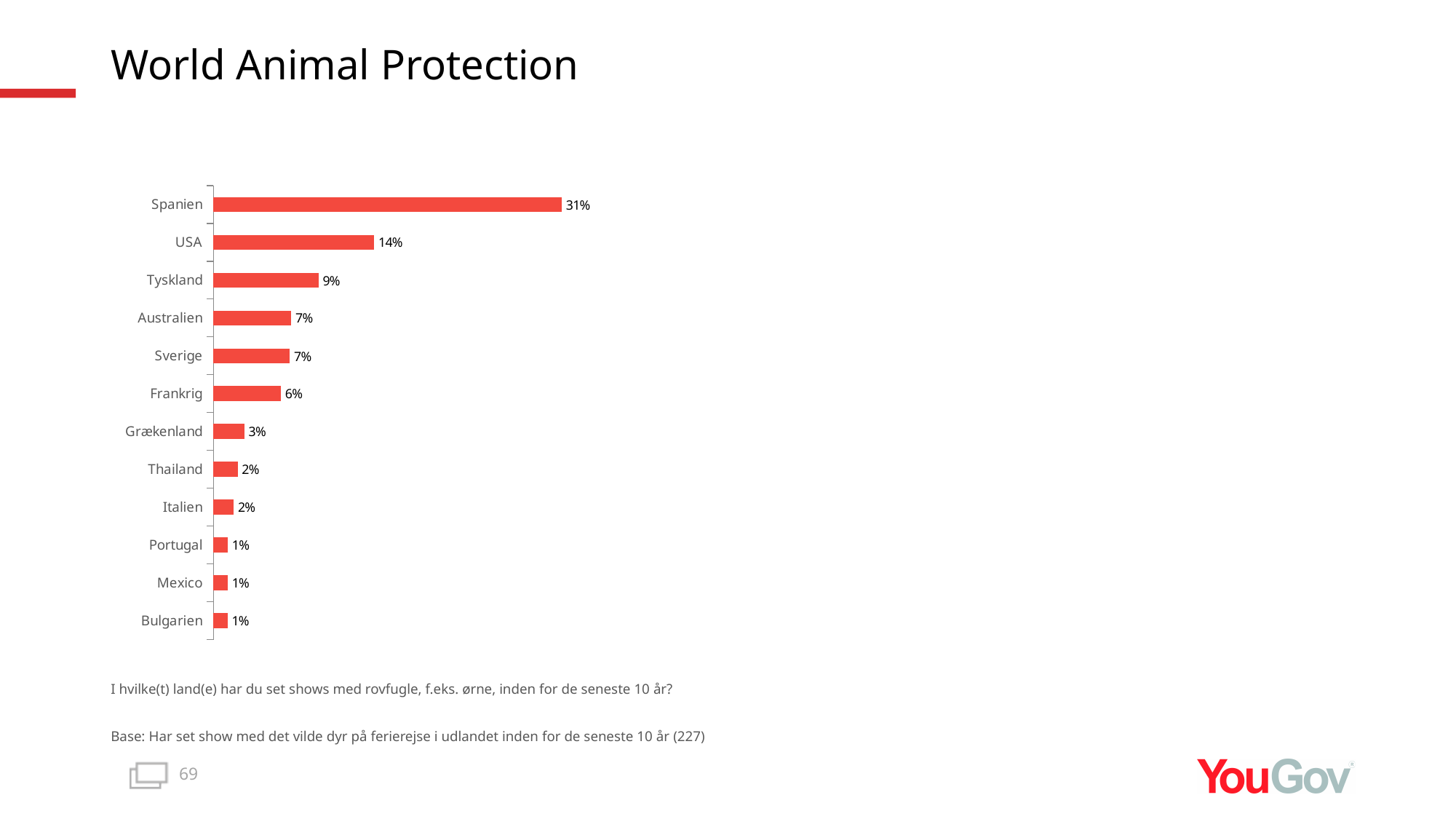
What is the difference between the values for Spanien and USA? 17% What kind of chart is shown on the slide? Bar chart Which is larger, the value for USA or the value for Australien? USA What colour are the bars in the chart? Red What is the difference between the values for Tyskland and Frankrig? 3% What is the value for Tyskland? 9% What is the value for USA? 14% How many countries are shown in the chart? 12 What is the value for Spanien? 31% Which country has the highest value? Spanien Which is larger, the value for Frankrig or the value for Thailand? Frankrig What is the value for Grækenland? 3%